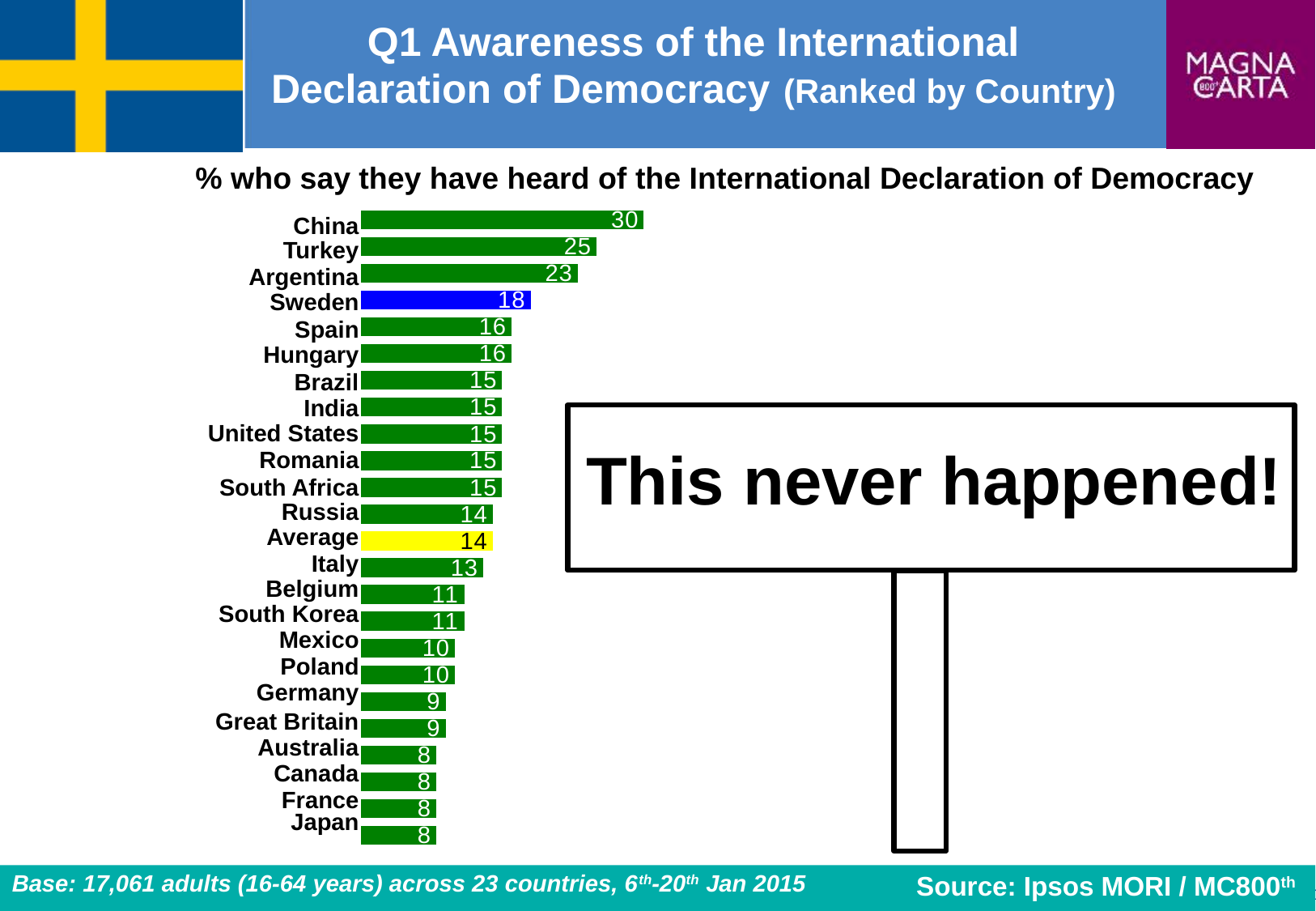
Which has a larger value, Argentina or Spain? Argentina What kind of chart is shown on the slide? Bar chart What is the value shown for Sweden? 18 What is the difference between the values for China and Turkey? 5 What is the value shown for Japan? 8 Which has a larger value, Italy or Germany? Italy What is the difference between the values for Sweden and the Average? 4 Which country has the highest value on the chart? China What is the value shown for the Average bar? 14 Which bar on the chart is coloured blue? Sweden What is the value shown for China? 30 How many bars are plotted on the chart, including the Average bar? 24